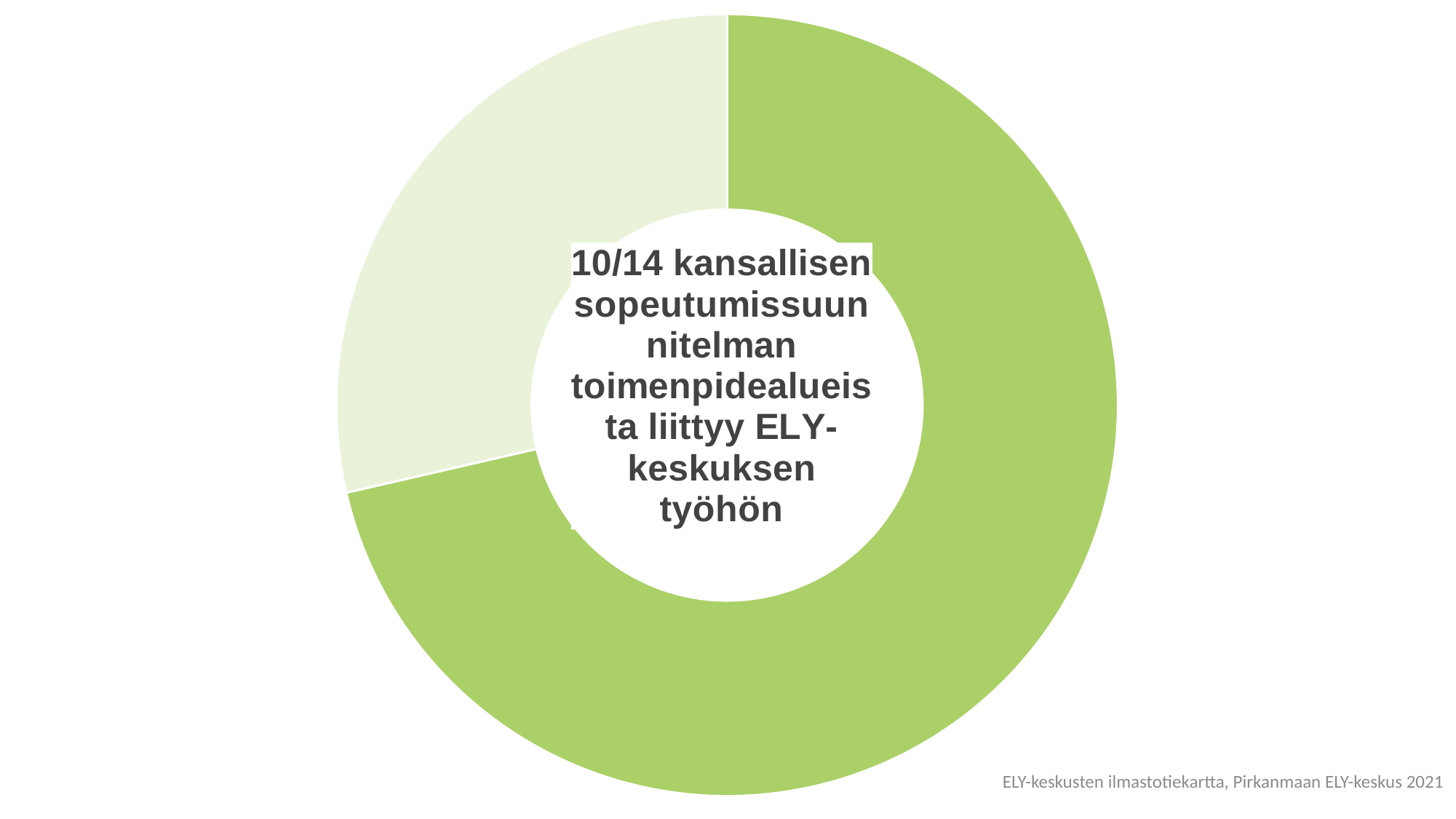
Does the donut chart have a legend? No What source is cited in the bottom right corner of the slide? ELY-keskusten ilmastotiekartta, Pirkanmaan ELY-keskus 2021 What fraction is stated in the centre of the donut chart? 10/14 According to the text in the centre of the chart, how many of the 14 national adaptation plan action areas relate to the ELY centre's work? 10 How many slices does the donut chart have? 2 Is the pale green slice greater or less than half of the donut chart? less Which slice of the donut chart is larger, the dark green one or the pale green one? The dark green one Is the dark green slice greater or less than half of the donut chart? greater What kind of chart is shown on the slide? Pie chart (donut)